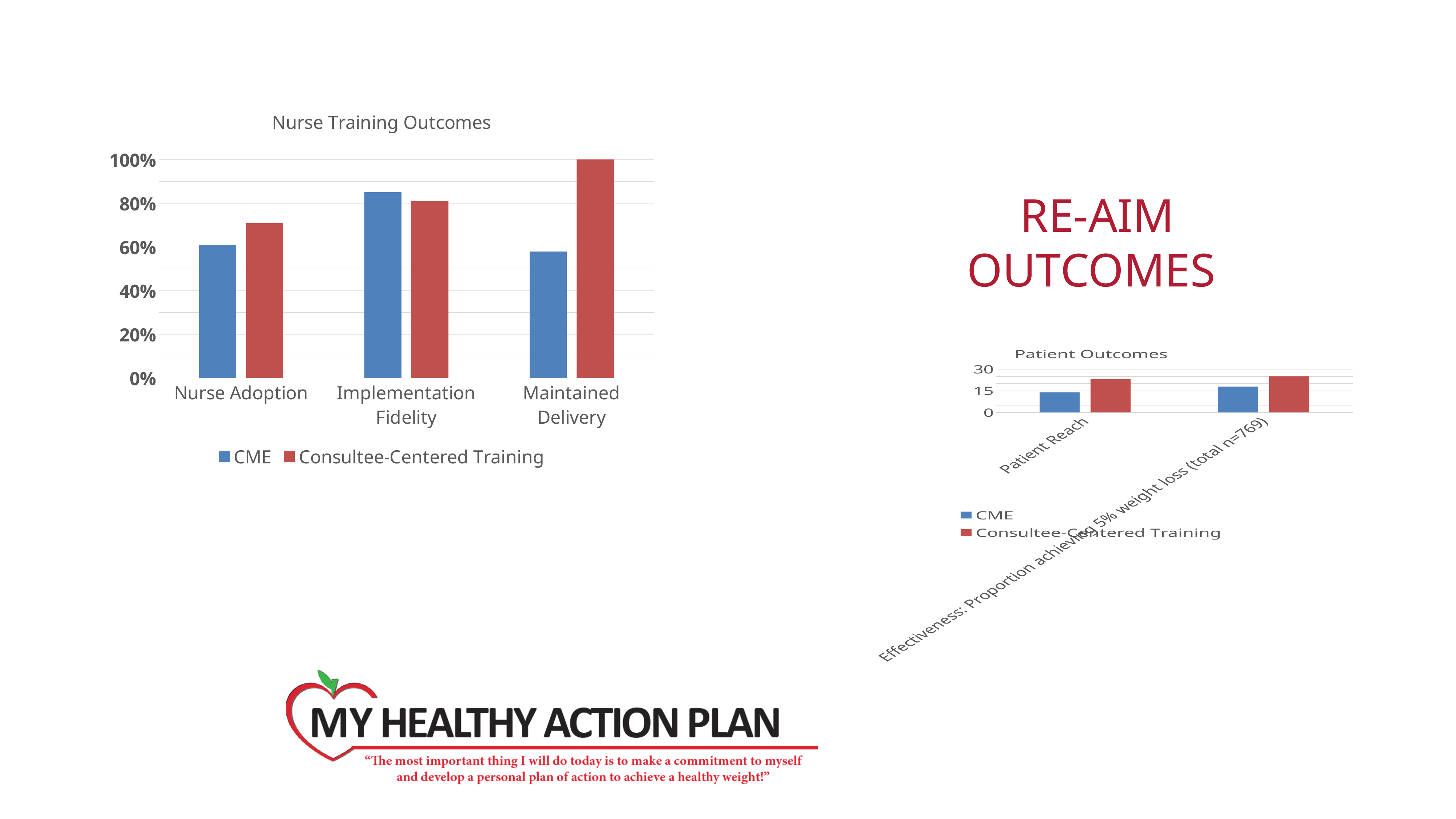
In the Nurse Training Outcomes chart, is the CME value for Implementation Fidelity greater or less than 80%? greater In the Nurse Training Outcomes chart, how many series does the legend list? 2 In the Nurse Training Outcomes chart, for Maintained Delivery, which series has the larger value, CME or Consultee-Centered Training? Consultee-Centered Training In the Nurse Training Outcomes chart, how many categories are shown on the x axis? 3 In the Nurse Training Outcomes chart, which category has the highest CME value? Implementation Fidelity In the Nurse Training Outcomes chart, is the CME value for Nurse Adoption greater or less than 80%? less In the Nurse Training Outcomes chart, which category has the highest Consultee-Centered Training value? Maintained Delivery In the Nurse Training Outcomes chart, what is the Consultee-Centered Training value for Maintained Delivery? 100% In the Patient Outcomes chart, for Patient Reach, which series has the larger value, CME or Consultee-Centered Training? Consultee-Centered Training In the Patient Outcomes chart, is the Consultee-Centered Training value for Patient Reach greater or less than 15? greater What is the title of the chart on the right side of the slide? Patient Outcomes What kind of chart is the Nurse Training Outcomes chart? bar chart